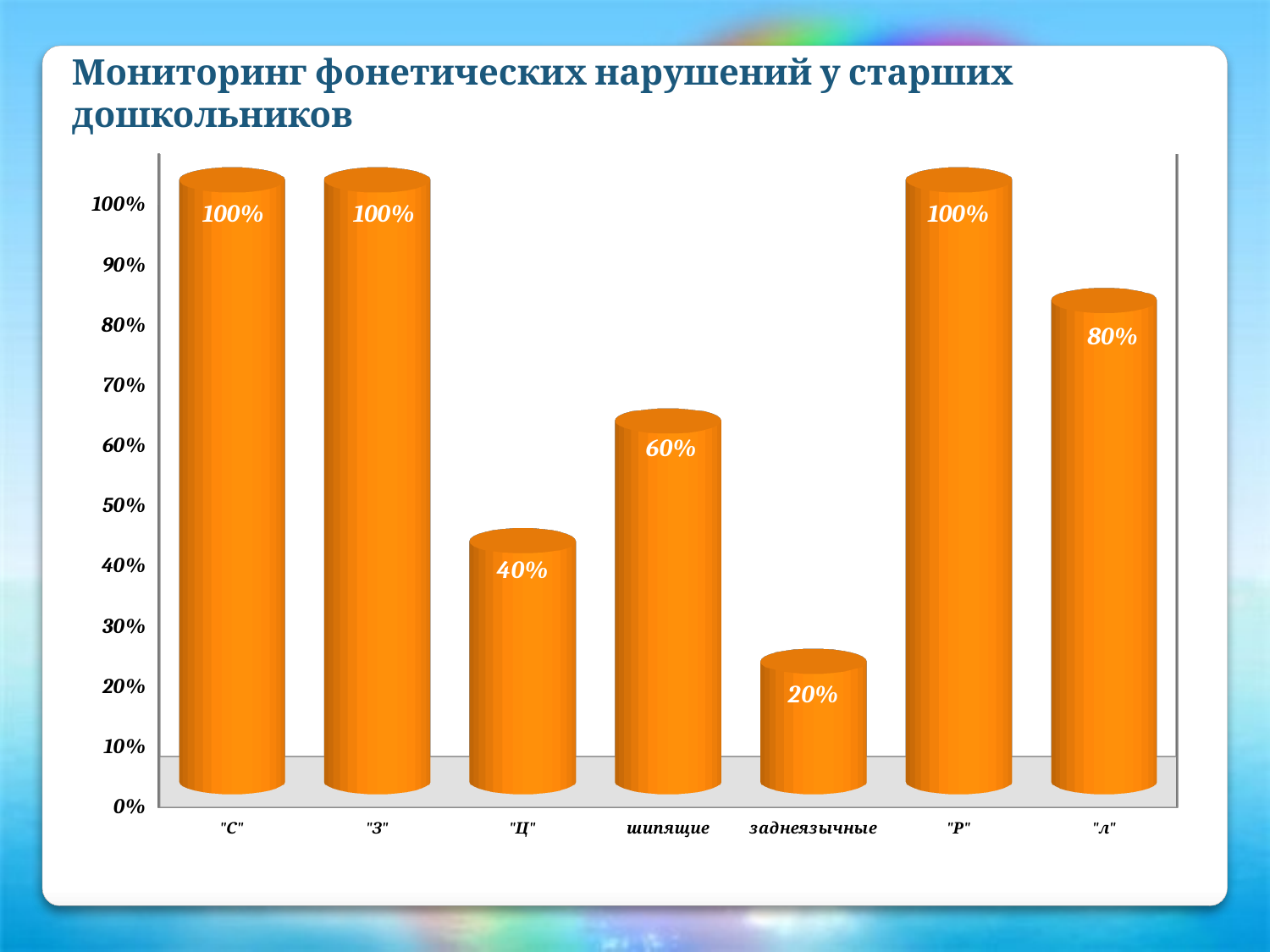
Which is larger, the value for "Р" or the value for "л"? "Р" Which category has the lowest value? заднеязычные What is the value for шипящие? 60% Which is larger, the value for "Ц" or the value for шипящие? шипящие What is the title of the chart on the slide? Мониторинг фонетических нарушений у старших дошкольников What is the difference between the values for "л" and "Ц"? 40% What is the value for заднеязычные? 20% How many categories are shown on the x axis? 7 What is the value for "л"? 80% What is the difference between the values for шипящие and заднеязычные? 40% What is the value for "Ц"? 40% What kind of chart is shown on the slide? bar chart